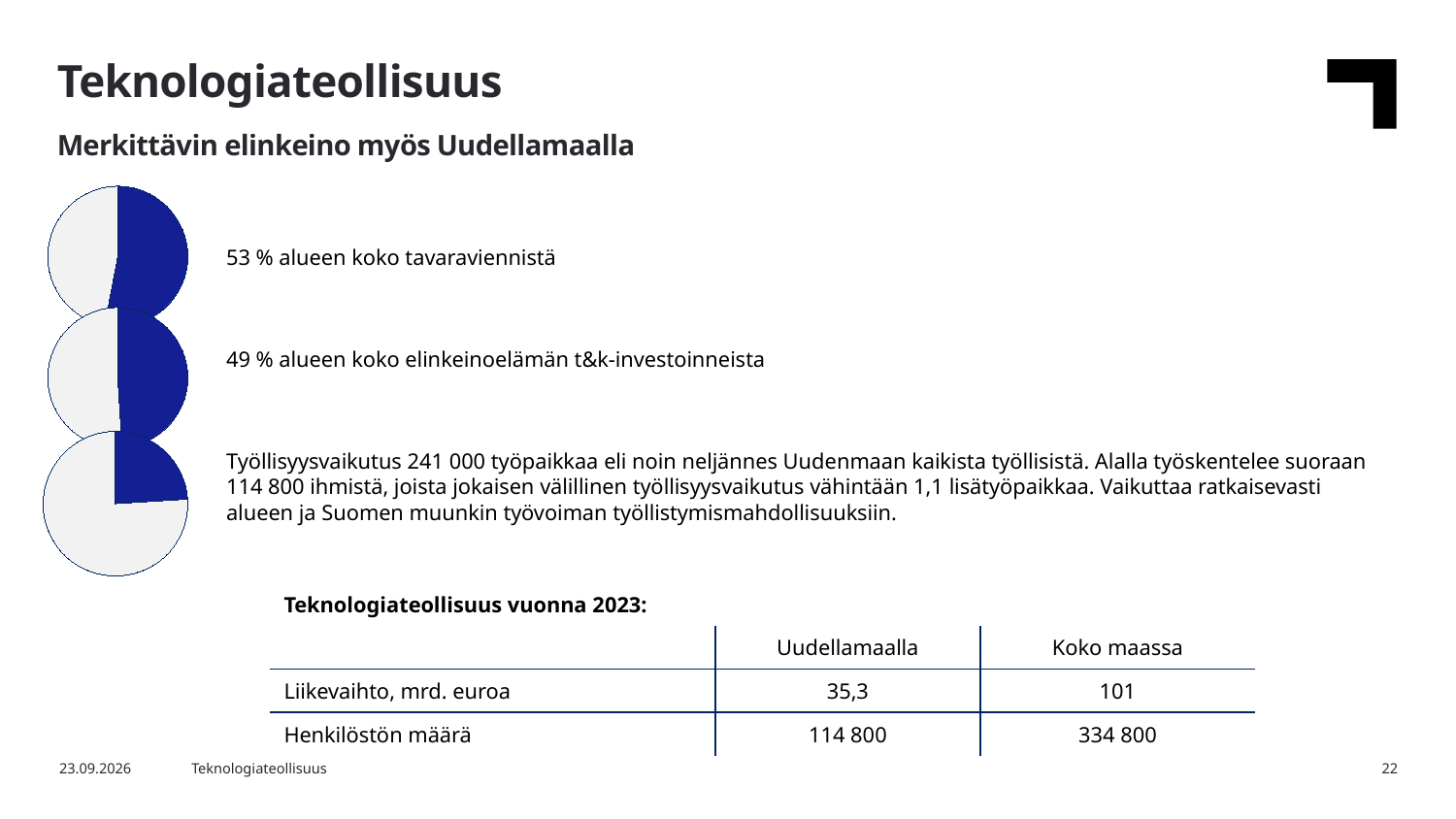
In the bottom pie chart, is the highlighted slice greater or less than 50% of the pie? less In the top pie chart, is the highlighted slice greater or less than 50% of the pie? greater What does the top pie chart represent, according to the text next to it? 53 % alueen koko tavaraviennistä What kind of charts are shown on the left side of the slide? Pie charts In the middle pie chart, what share of the region's business R&D investments does the highlighted slice represent? 49 % What is the difference in percentage points between the highlighted share in the top pie chart (53 %) and the middle pie chart (49 %)? 4 percentage points Which pie chart has the largest highlighted slice: the top, middle or bottom one? Top In the top pie chart, what share of the region's total goods exports does the highlighted slice represent? 53 % How many pie charts are shown on the slide? 3 Which pie chart has the smallest highlighted slice: the top, middle or bottom one? Bottom What colour is the highlighted slice in each of the pie charts? Dark blue